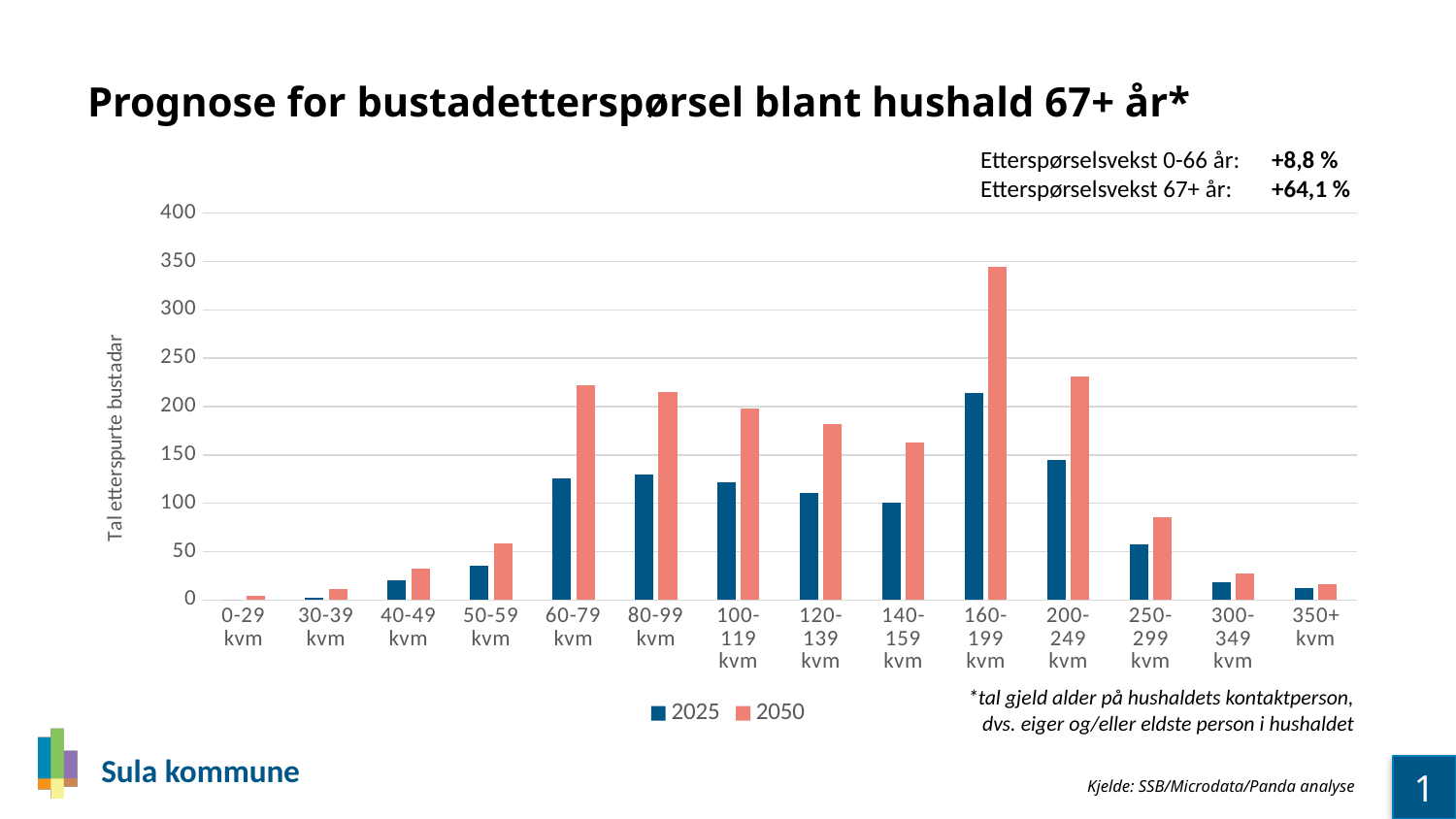
What is the title of the y axis? Tal etterspurte bustadar How many size categories are shown on the x axis? 14 What are the two entries in the legend? 2025 and 2050 How many series does the legend list? 2 Is the 2025 value for 250-299 kvm greater or less than 100? less Is the 2050 value for 160-199 kvm greater or less than 300? greater Which size category has the highest value for 2025? 160-199 kvm For 60-79 kvm, which series has the larger value, 2025 or 2050? 2050 Which size category has the highest value for 2050? 160-199 kvm Is the 2050 value for 200-249 kvm greater or less than 200? greater What kind of chart is shown on the slide? bar chart Which size category has the lowest value for 2050? 0-29 kvm